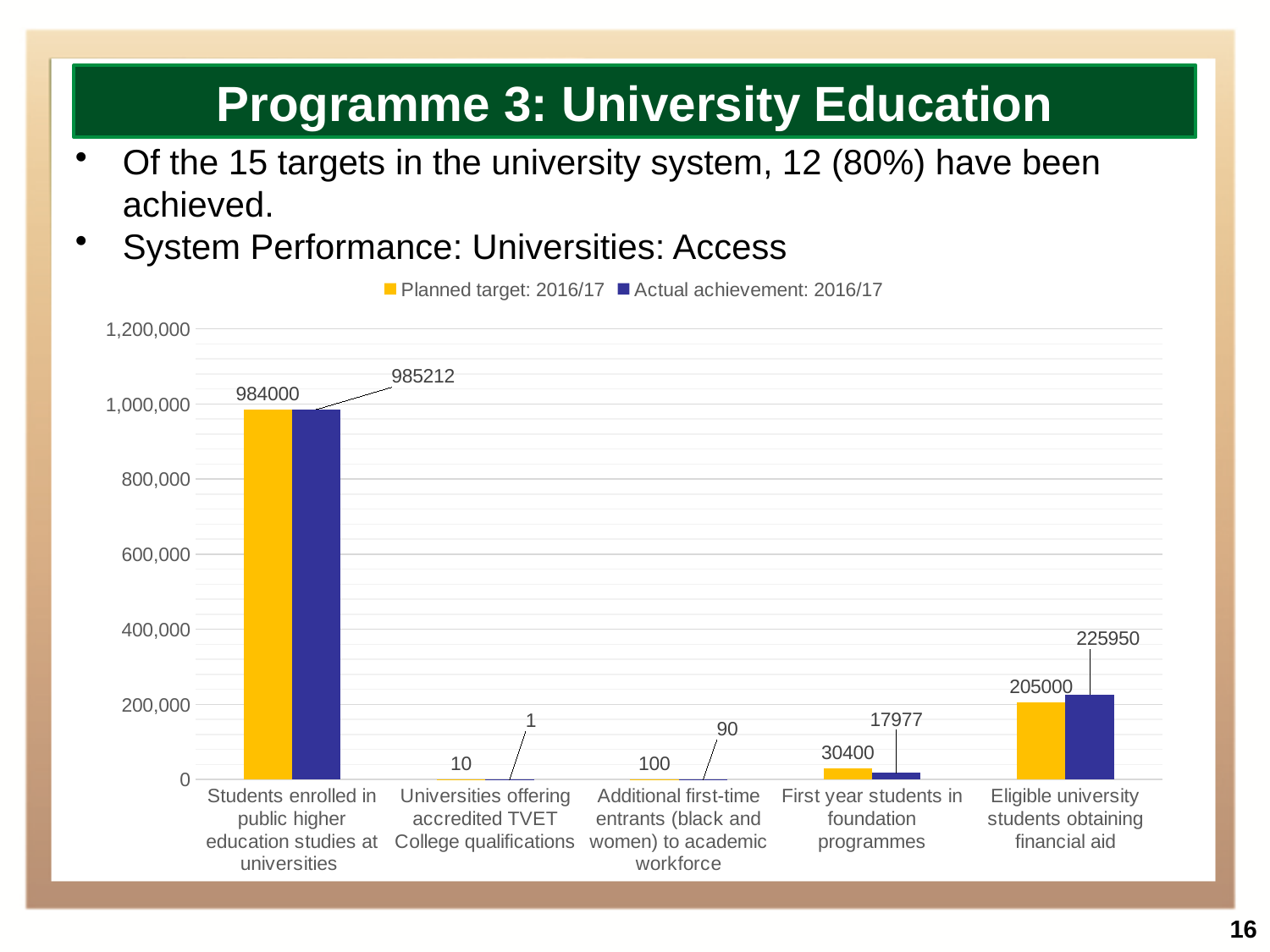
What is the planned target for 2016/17 for universities offering accredited TVET College qualifications? 10 What type of chart is shown on the slide? Bar chart How many series does the chart legend list? 2 What is the difference between the planned target and the actual achievement for first year students in foundation programmes? 12423 By how much does the actual achievement exceed the planned target for eligible university students obtaining financial aid? 20950 Which category has the lowest actual achievement for 2016/17? Universities offering accredited TVET College qualifications Which category has the highest planned target for 2016/17? Students enrolled in public higher education studies at universities How many categories are shown on the x axis of the chart? 5 What is the planned target for 2016/17 for students enrolled in public higher education studies at universities? 984000 For first year students in foundation programmes, which is larger: the planned target or the actual achievement? Planned target What is the actual achievement for 2016/17 for eligible university students obtaining financial aid? 225950 What is the actual achievement for 2016/17 for first year students in foundation programmes? 17977